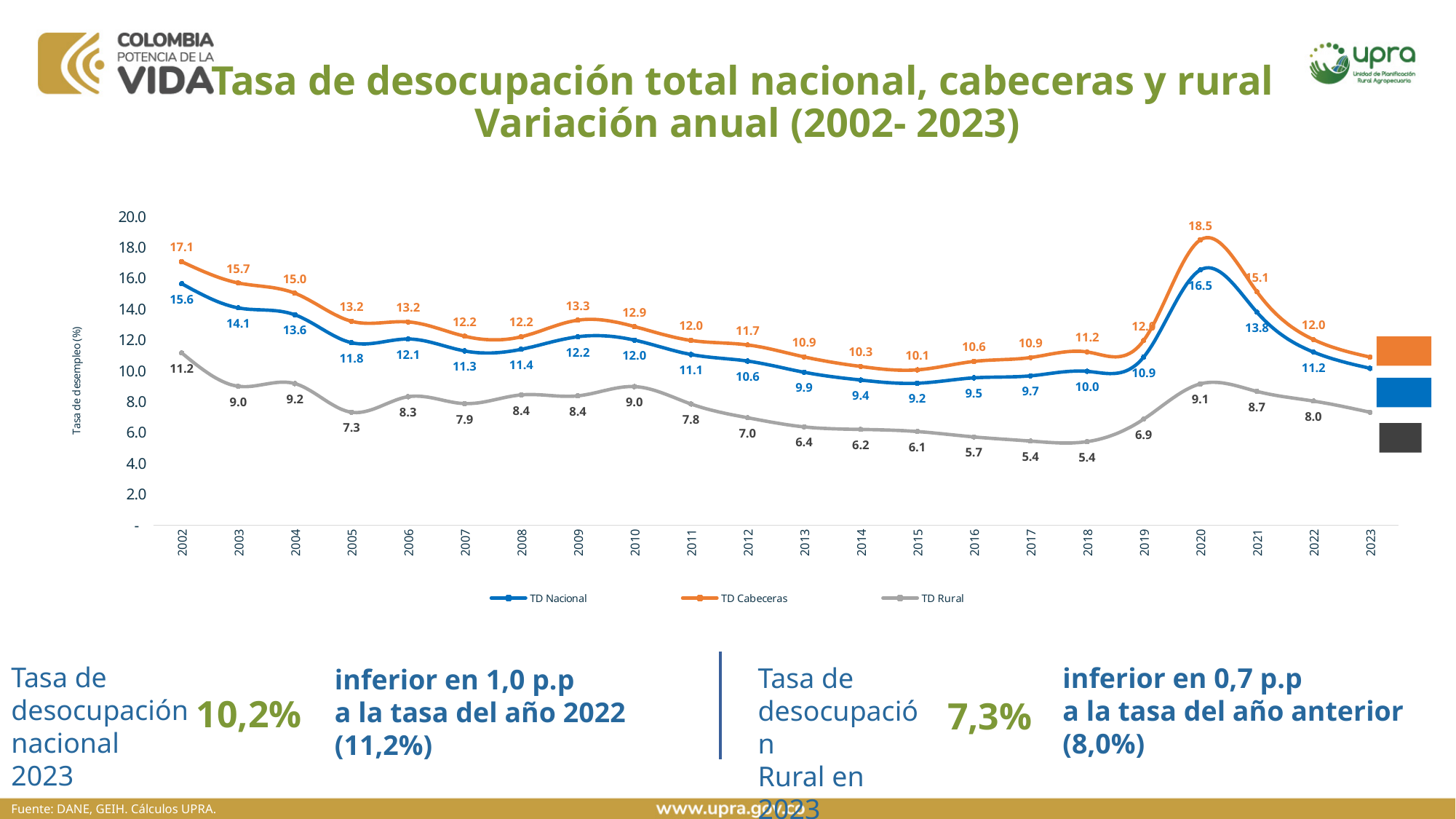
Does TD Rural rise or fall from 2002 to 2005? fall By how much did TD Nacional increase from 2019 to 2020? 5.6 What is the difference between TD Cabeceras and TD Nacional in 2002? 1.5 How many series does the legend list? 3 What type of chart is shown on the slide? line chart How many years are shown on the x axis? 22 Which is larger for TD Nacional, the value in 2009 or the value in 2010? 2009 What is the value of TD Cabeceras in 2020? 18.5 What is the value of TD Rural in 2015? 6.1 In which year does TD Nacional reach its highest value? 2020 In which year does TD Cabeceras reach its lowest value? 2015 What is the value of TD Nacional in 2005? 11.8